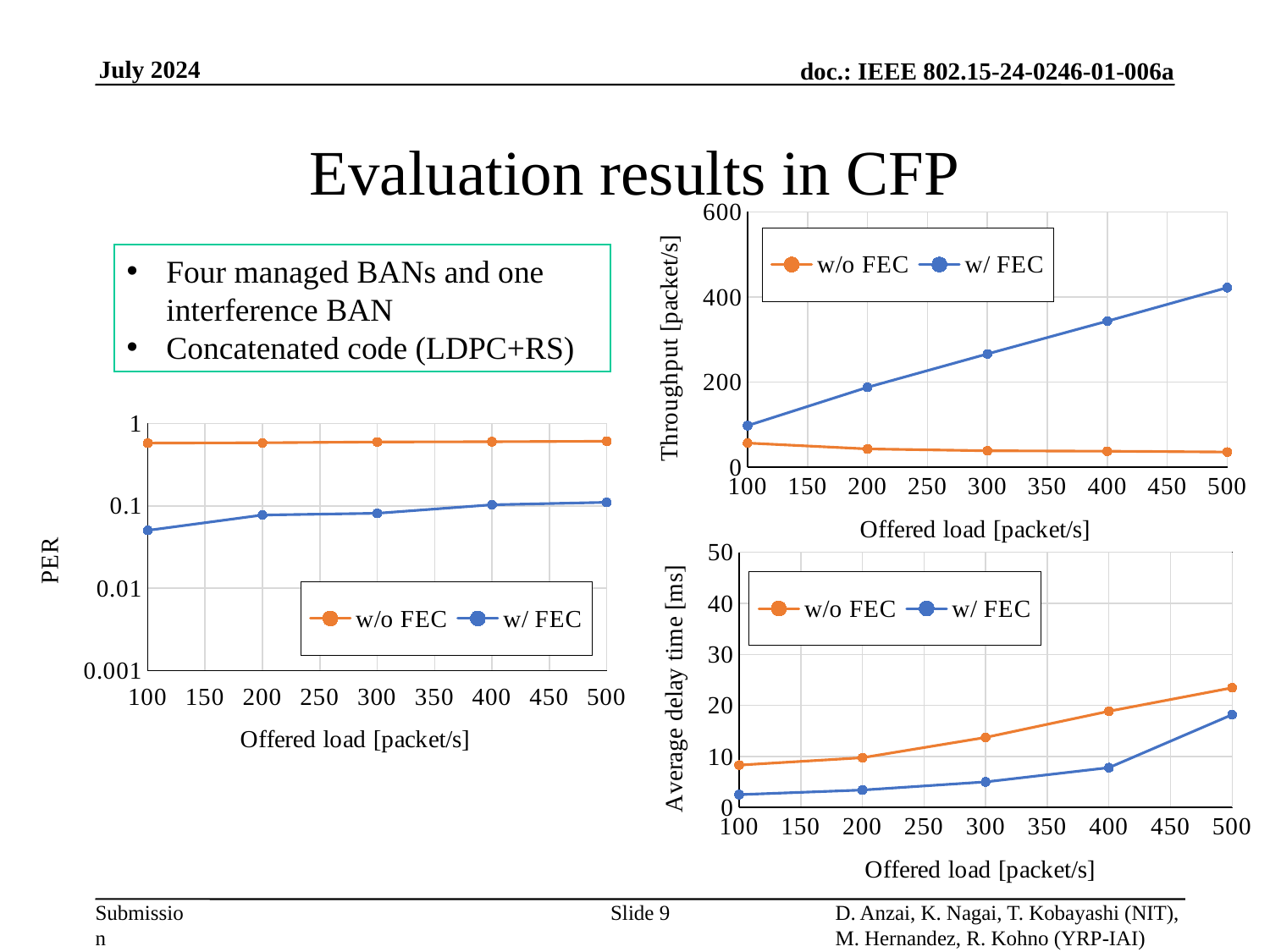
How many series does the legend of the Throughput chart list? 2 In the Average delay time chart, is the w/o FEC value at an offered load of 500 packet/s greater or less than 20? greater In the Average delay time chart, is the w/ FEC value at an offered load of 200 packet/s greater or less than 10? less In the Throughput chart, does the w/o FEC series rise or fall as offered load increases? fall What kind of chart is the PER chart on the left of the slide? line chart In the Throughput chart, which series has the higher value at an offered load of 300 packet/s, w/o FEC or w/ FEC? w/ FEC What is the x-axis label of the Average delay time chart? Offered load [packet/s] In the Throughput chart, does the w/ FEC series rise or fall as offered load increases? rise In the Throughput chart, is the w/ FEC value at an offered load of 500 packet/s greater or less than 400? greater How many data points does the w/ FEC series have in the Average delay time chart? 5